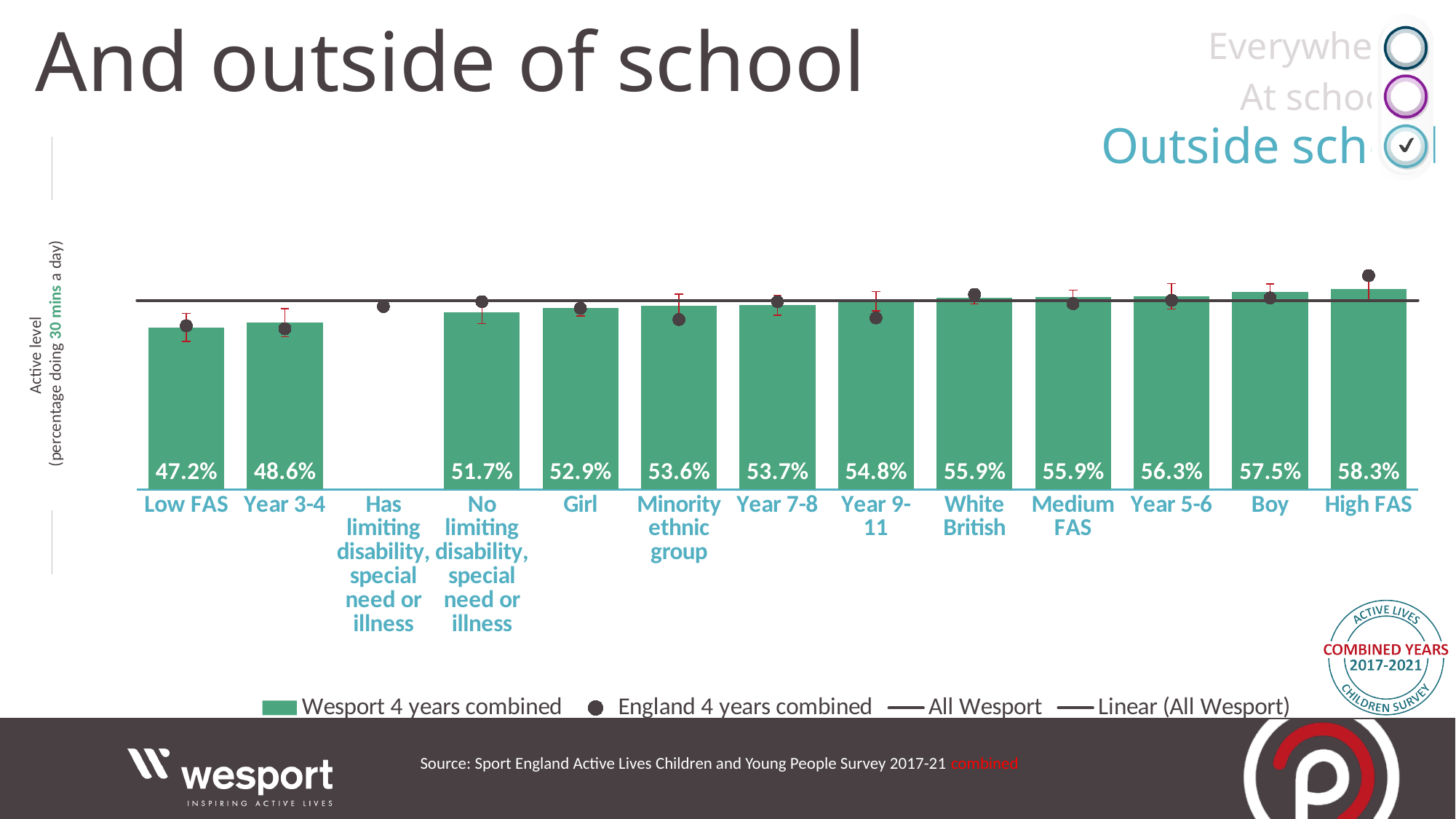
Which category has the highest Wesport 4 years combined value? High FAS What kind of chart is shown on the slide? Bar chart Which has a higher Wesport value, Boy or Girl? Boy What is the Wesport 4 years combined value for Girl? 52.9% How many series does the legend list? 4 Which labelled bar has the lowest Wesport 4 years combined value? Low FAS What is the Wesport 4 years combined value for Year 9-11? 54.8% Do the Wesport bar values rise or fall from left to right along the x axis? Rise What is the difference between the Wesport values for Year 5-6 and Year 3-4? 7.7% What is the Wesport 4 years combined value for Boy? 57.5% What is the difference between the Wesport values for High FAS and Low FAS? 11.1% What is the Wesport 4 years combined value for Low FAS? 47.2%